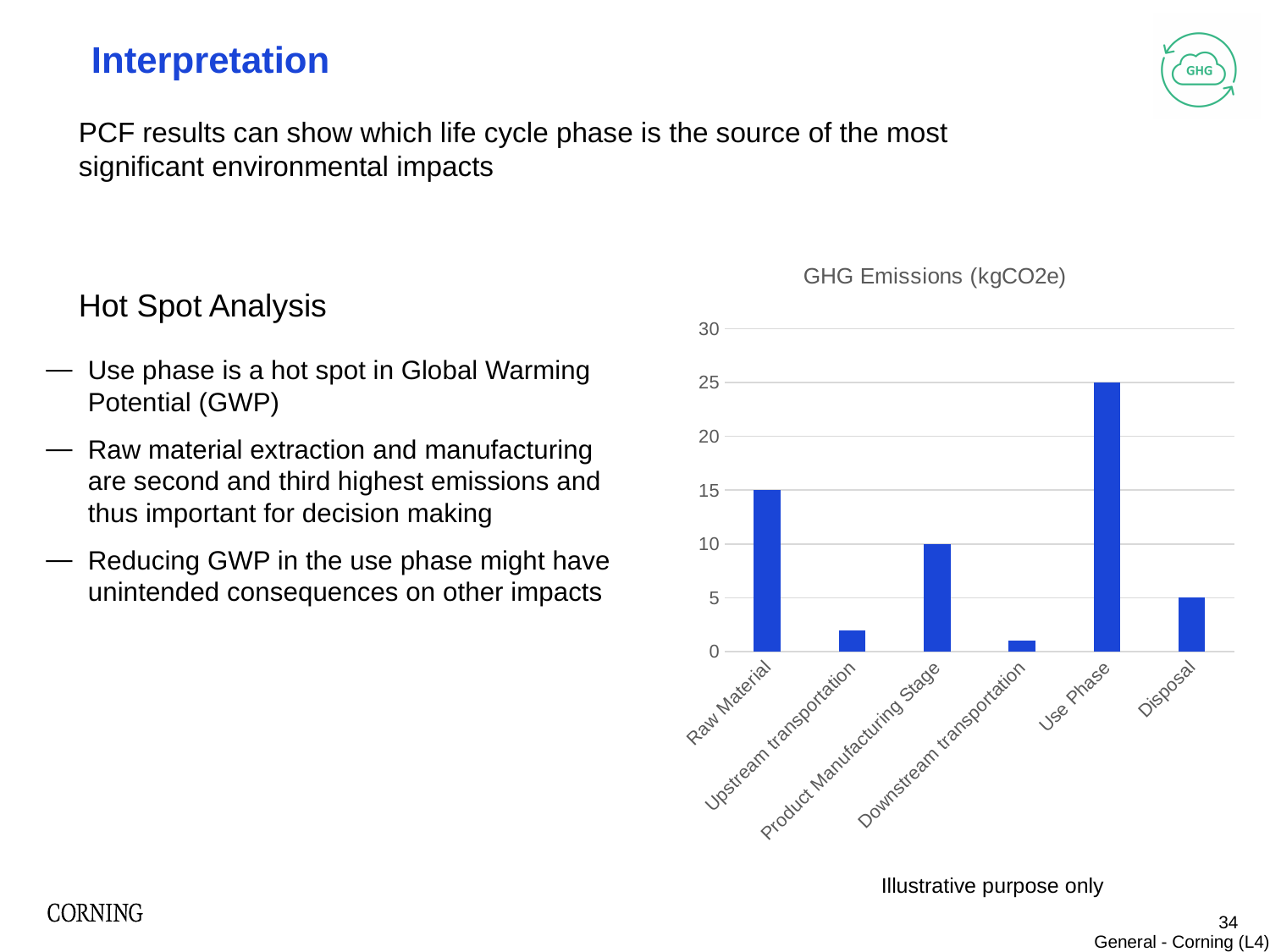
What is the difference between the Use Phase and Raw Material values in the GHG Emissions chart? 10 Which category has the highest GHG emissions in the chart? Use Phase Is the value for Downstream transportation greater or less than 5? less What is the value for Raw Material in the GHG Emissions chart? 15 What is the value for Product Manufacturing Stage in the GHG Emissions chart? 10 Is the value for Upstream transportation greater or less than 5? less What is the value for Use Phase in the GHG Emissions chart? 25 What is the difference between the Raw Material and Product Manufacturing Stage values in the GHG Emissions chart? 5 What type of chart is used to show GHG Emissions on the slide? Bar chart Which is larger in the GHG Emissions chart, Raw Material or Disposal? Raw Material What is the value for Disposal in the GHG Emissions chart? 5 How many categories are shown in the GHG Emissions chart? 6